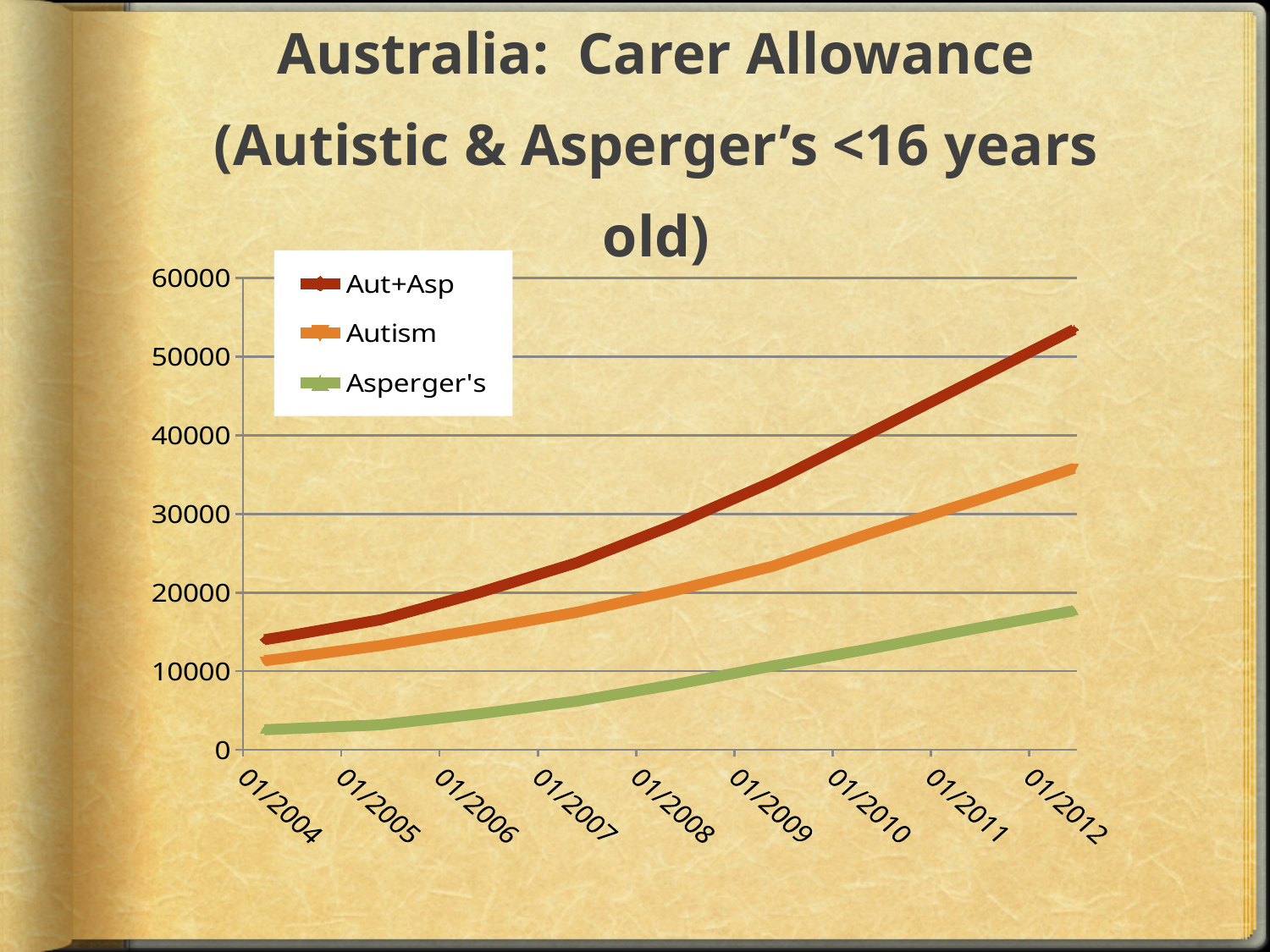
How many series does the legend list? 3 Is the value for Aut+Asp at 01/2012 greater or less than 50000? greater Which series has the lowest values across the whole chart? Asperger's What kind of chart is shown on the slide? line chart What is the title of the chart? Australia: Carer Allowance (Autistic & Asperger's <16 years old) Is the value for Asperger's at 01/2004 greater or less than 10000? less Is the value for Asperger's at 01/2012 greater or less than 20000? less Which series has the highest values across the whole chart? Aut+Asp Do the values for the Aut+Asp series rise or fall from 01/2004 to 01/2012? rise At 01/2012, which is larger: the value for Autism or the value for Asperger's? Autism